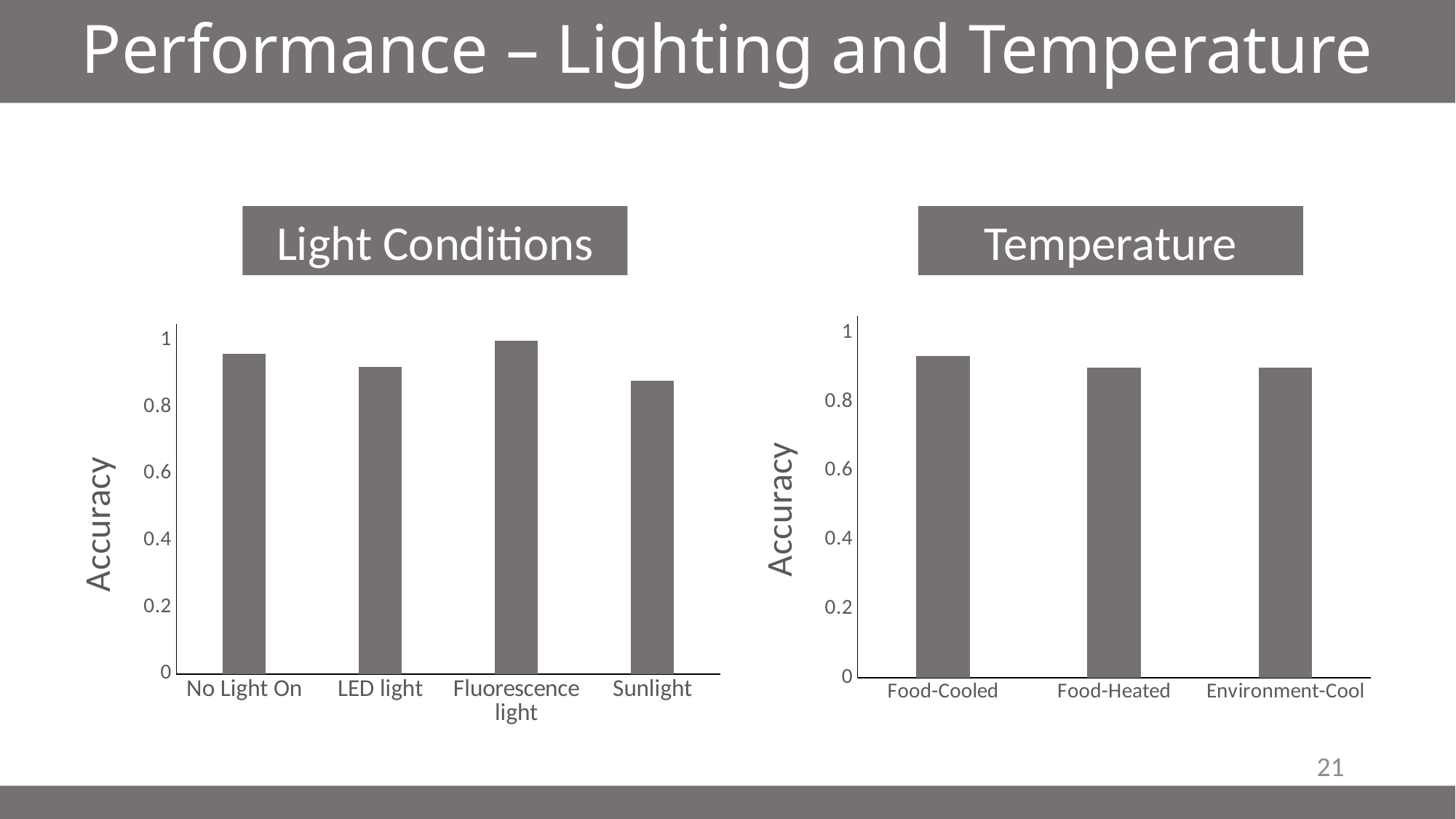
In the Light Conditions chart, is the accuracy for Sunlight greater or less than 0.8? greater In the Light Conditions chart, which is larger, the accuracy for Fluorescence light or for Sunlight? Fluorescence light In the Light Conditions chart, which category has the lowest accuracy? Sunlight In the Temperature chart, is the accuracy for Food-Heated greater or less than 0.8? greater In the Light Conditions chart, which category has the highest accuracy? Fluorescence light What kind of chart is the Light Conditions chart? bar chart What is the label on the vertical axis of the Temperature chart? Accuracy In the Temperature chart, which category has the highest accuracy? Food-Cooled What is the title of the chart on the left side of the slide? Light Conditions How many categories are shown in the Temperature chart? 3 In the Light Conditions chart, is the accuracy for LED light greater or less than 1? less How many categories are shown in the Light Conditions chart? 4